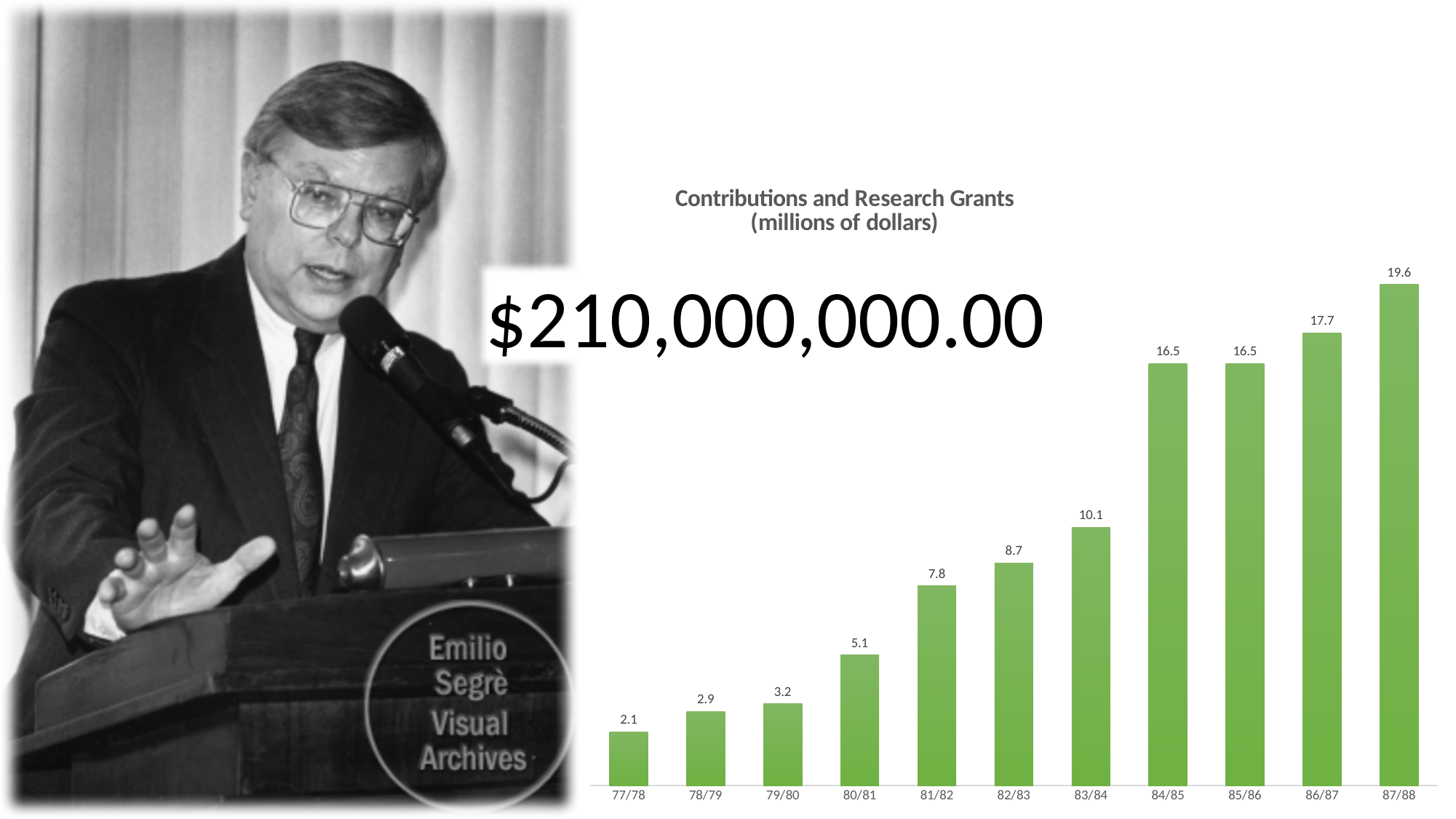
How many years are shown in the Contributions and Research Grants chart? 11 Which year has the lowest value in the Contributions and Research Grants chart? 77/78 What unit does the title of the Contributions and Research Grants chart say the values are in? millions of dollars Which is larger in the Contributions and Research Grants chart, the value for 82/83 or the value for 81/82? 82/83 What is the difference between the values for 87/88 and 77/78 in the Contributions and Research Grants chart? 17.5 Do the values in the Contributions and Research Grants chart generally rise or fall from 77/78 to 87/88? rise Which two years in the Contributions and Research Grants chart have the same value of 16.5? 84/85 and 85/86 Which year has the highest value in the Contributions and Research Grants chart? 87/88 What is the difference between the values for 84/85 and 83/84 in the Contributions and Research Grants chart? 6.4 What kind of chart is the Contributions and Research Grants chart? bar chart What is the value for 86/87 in the Contributions and Research Grants chart? 17.7 What is the value for 80/81 in the Contributions and Research Grants chart? 5.1